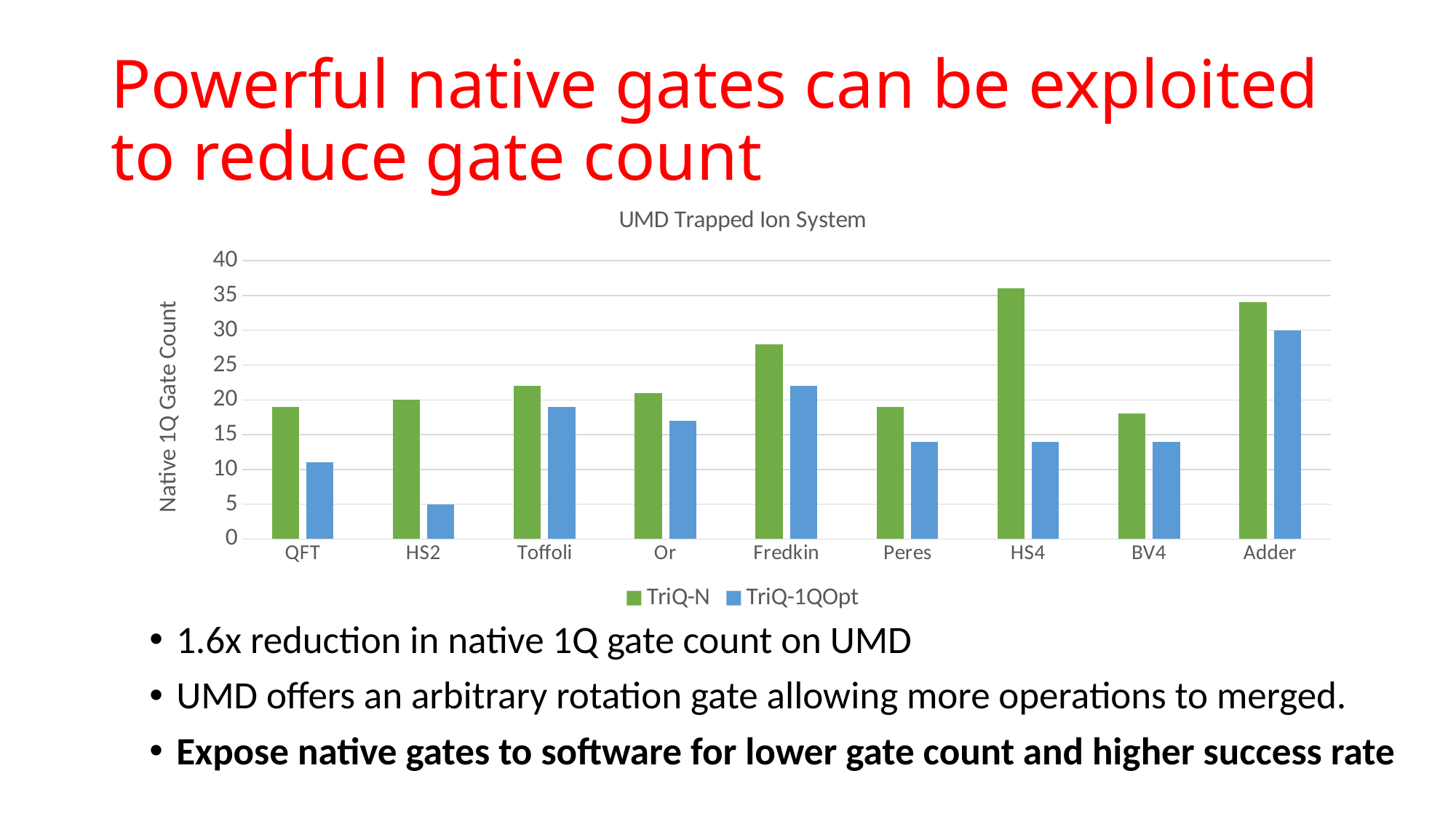
Is the TriQ-N value for Fredkin greater or less than 25? greater How many series does the legend list? 2 What is the title of the chart? UMD Trapped Ion System Is the TriQ-1QOpt value for HS2 greater or less than 10? less Is the TriQ-N value for HS4 greater or less than 35? greater For QFT, which series has the larger value, TriQ-N or TriQ-1QOpt? TriQ-N How many benchmark categories are shown on the x axis? 9 Which category has the highest TriQ-1QOpt native 1Q gate count? Adder What is the label of the vertical axis? Native 1Q Gate Count Which category has the highest TriQ-N native 1Q gate count? HS4 Which category has the lowest TriQ-1QOpt native 1Q gate count? HS2 What type of chart is shown on the slide? bar chart